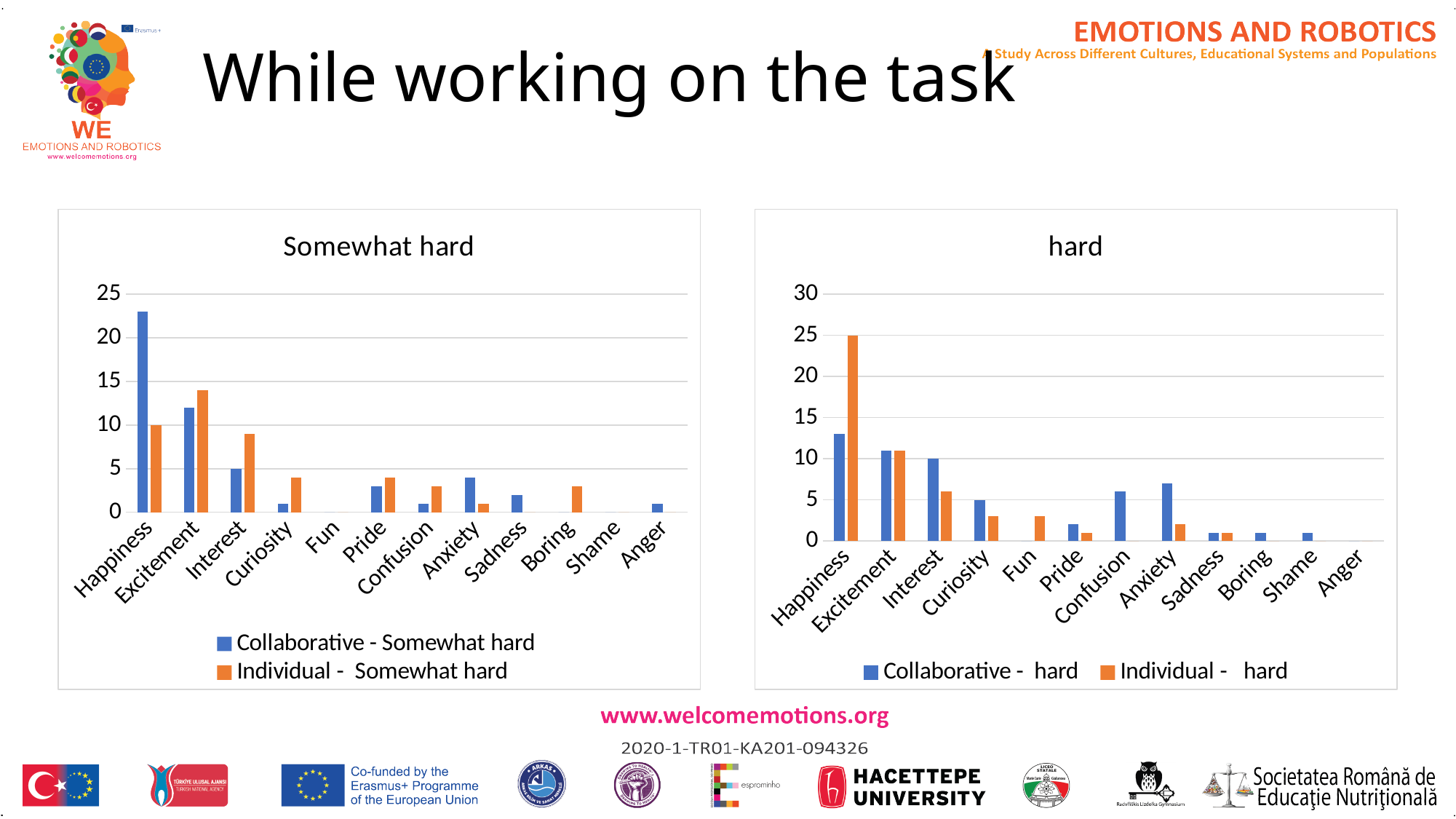
What are the two legend entries of the "hard" chart on the right? Collaborative - hard; Individual - hard How many series does the legend of the "hard" chart on the right list? 2 In the "Somewhat hard" chart, do the Collaborative values generally rise or fall from Happiness to Anger along the x axis? fall In the "hard" chart, is the Collaborative value for Happiness greater or less than 10? greater What kind of chart is the "Somewhat hard" chart on the left? bar chart In the "Somewhat hard" chart, which is larger for Excitement: the Collaborative value or the Individual value? Individual In the "Somewhat hard" chart, which emotion has the highest Collaborative value? Happiness In the "hard" chart, which is larger for Interest: the Collaborative value or the Individual value? Collaborative How many emotion categories are shown on the x axis of the "Somewhat hard" chart? 12 In the "hard" chart, which emotion has the highest Individual value? Happiness In the "hard" chart, is the Individual value for Happiness greater or less than 20? greater In the "Somewhat hard" chart, is the Collaborative value for Happiness greater or less than 20? greater